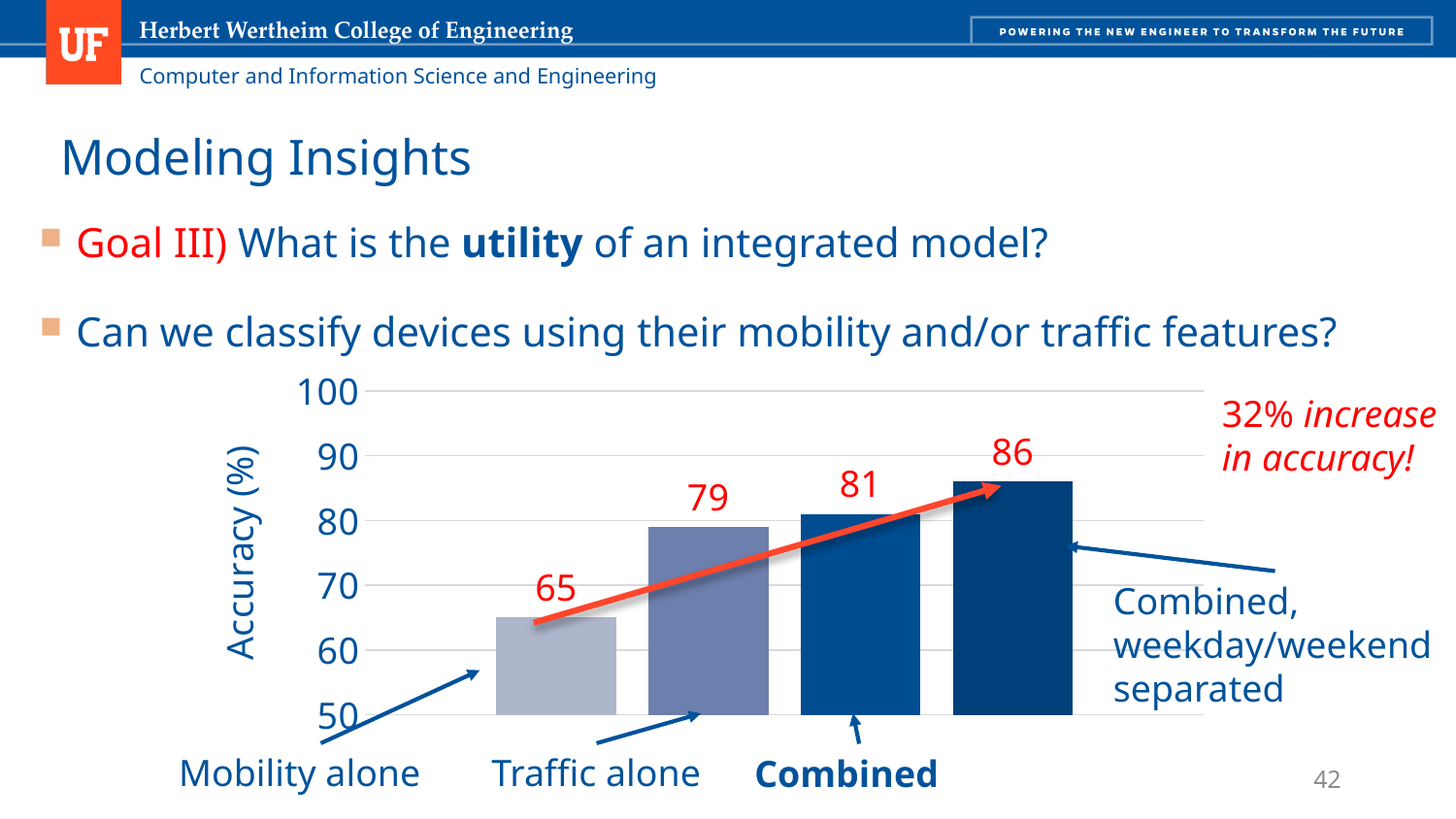
Which bar has the lowest accuracy? Mobility alone How many bars are plotted in the chart? 4 What accuracy value is shown for the "Mobility alone" bar? 65 What is the label of the vertical axis of the chart? Accuracy (%) What accuracy value is shown for the "Traffic alone" bar? 79 Which has a higher accuracy, "Traffic alone" or "Mobility alone"? Traffic alone What is the difference in accuracy between the "Combined, weekday/weekend separated" bar and the "Mobility alone" bar? 21 What accuracy value is shown for the "Combined" bar? 81 Which bar has the highest accuracy? Combined, weekday/weekend separated What kind of chart is shown on the slide? Bar chart What accuracy value is shown for the "Combined, weekday/weekend separated" bar? 86 What is the difference in accuracy between the "Traffic alone" bar and the "Mobility alone" bar? 14